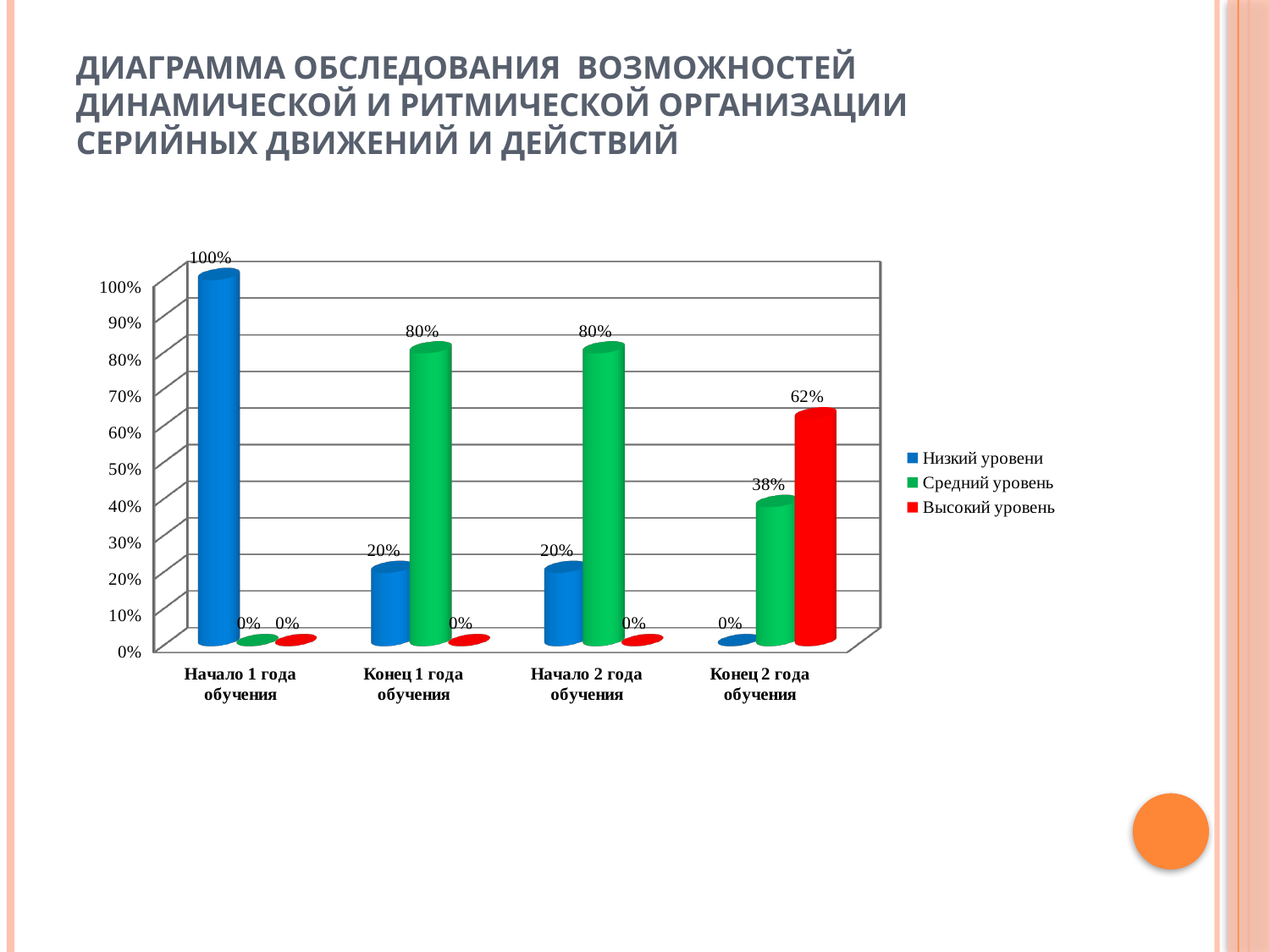
How many series does the legend list? 3 Which category has the lowest value for Средний уровень? Начало 1 года обучения At Конец 1 года обучения, which is larger: Низкий уровени or Средний уровень? Средний уровень What is the value for Средний уровень at Конец 2 года обучения? 38% What is the value for Высокий уровень at Конец 2 года обучения? 62% Which category has the highest value for Низкий уровени? Начало 1 года обучения What is the value for Низкий уровени at Начало 1 года обучения? 100% What is the value for Высокий уровень at Начало 2 года обучения? 0% What kind of chart is shown on the slide? Bar chart What is the value for Средний уровень at Конец 1 года обучения? 80% What is the difference between Высокий уровень and Средний уровень at Конец 2 года обучения? 24% How many categories are shown on the x axis? 4